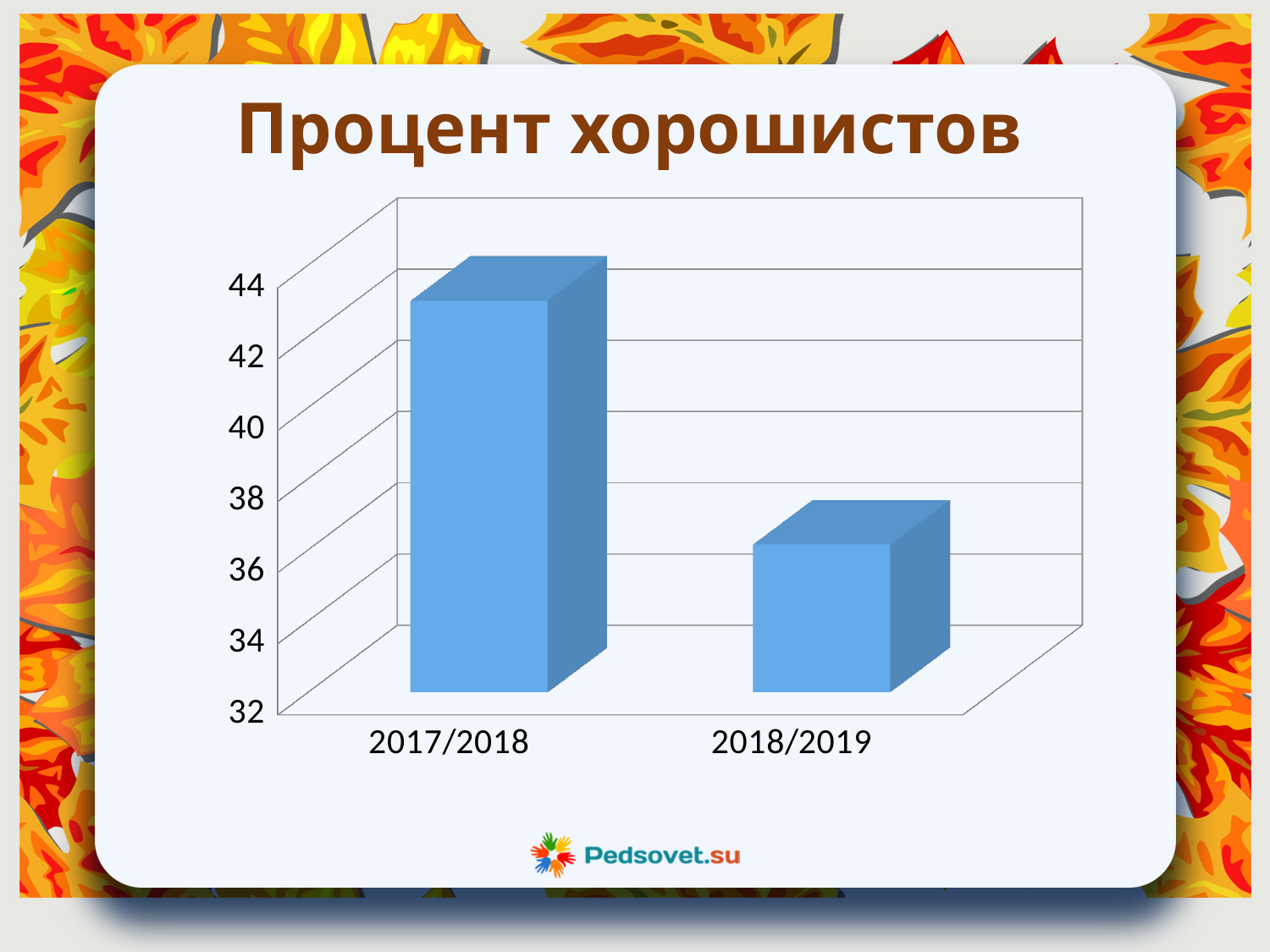
Is the value for 2017/2018 greater or less than 42? greater Which category has the lowest value? 2018/2019 Do the values rise or fall from 2017/2018 to 2018/2019? fall Which is larger, the value for 2017/2018 or the value for 2018/2019? 2017/2018 What is the lowest value shown on the vertical axis? 32 Is the value for 2018/2019 greater or less than 34? greater Is the value for 2018/2019 greater or less than 38? less What kind of chart is shown on the slide? bar chart How many categories are plotted on the chart? 2 Which category has the highest value? 2017/2018 What is the title of the chart? Процент хорошистов